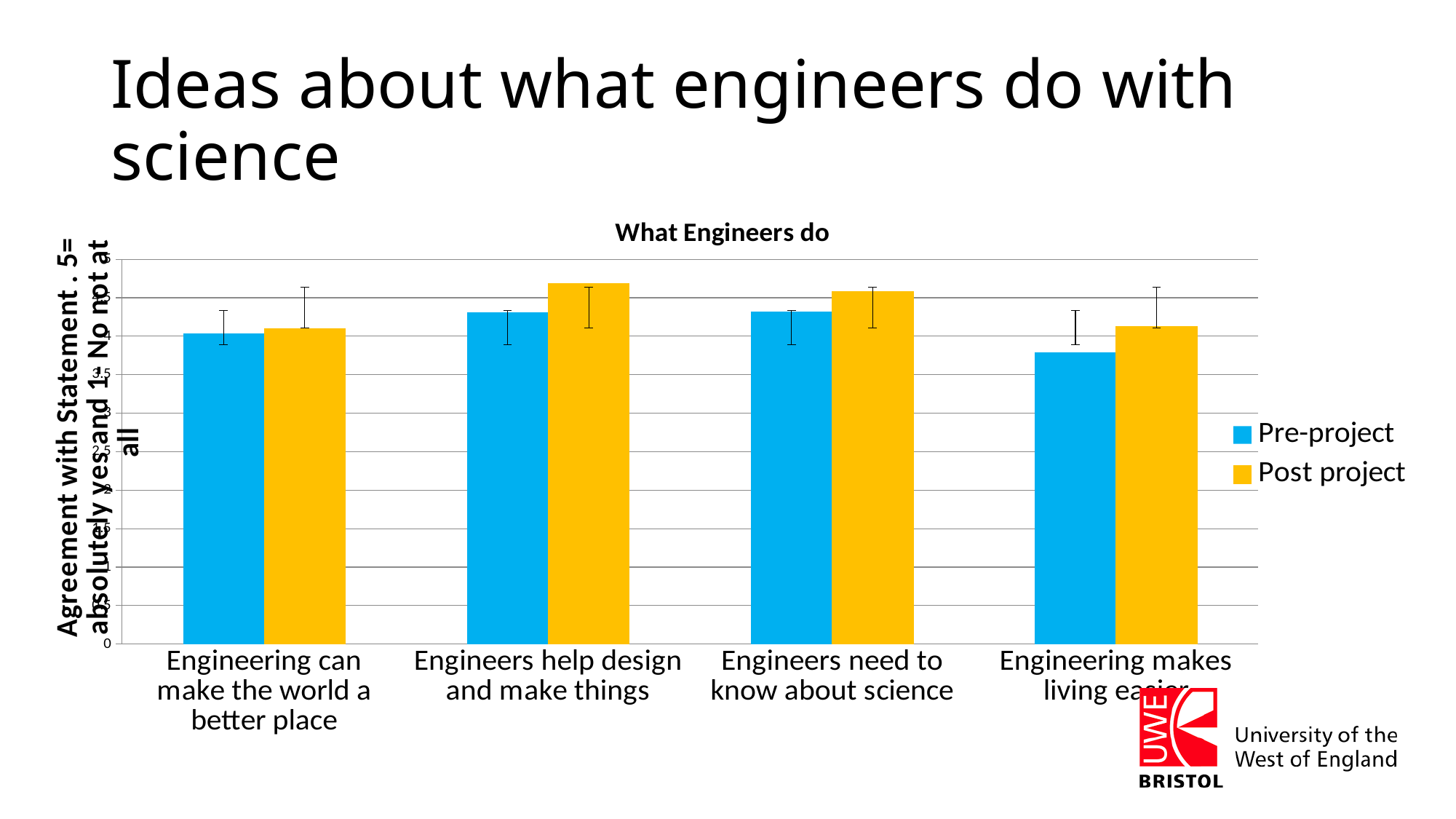
Is the Pre-project value for 'Engineers help design and make things' greater or less than 4? greater Is the Post project value for 'Engineers help design and make things' greater or less than 4.5? greater What kind of chart is shown on the slide? Bar chart For 'Engineers help design and make things', which is larger: the Pre-project or the Post project value? Post project Is the Pre-project value for 'Engineering makes living easier' greater or less than 4? less For 'Engineering makes living easier', which is larger: the Pre-project or the Post project value? Post project What is the title of the chart? What Engineers do How many series does the legend list? 2 Which statement has the lowest Pre-project value? Engineering makes living easier Which statement has the highest Post project value? Engineers help design and make things How many statement categories are shown on the x axis? 4 Which series is shown in blue? Pre-project